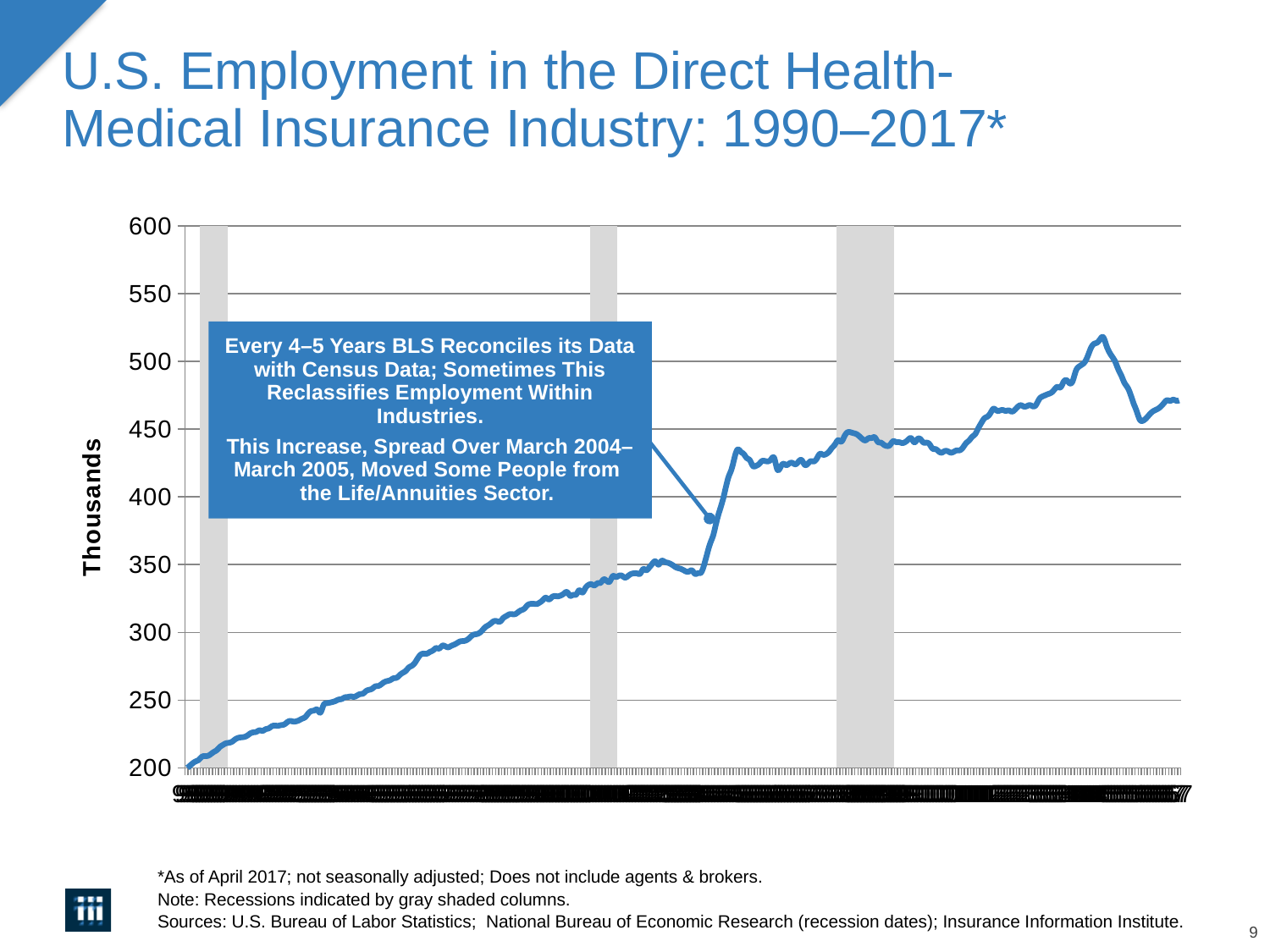
What is the highest tick value shown on the vertical axis? 600 What kind of chart is shown on the slide? line chart Is the value of the line just before the sharp jump (early 2004) greater or less than 400? less How many gray shaded recession columns are shown on the chart? 3 Is the first point of the line (1990) greater or less than 250? less What is the label on the vertical axis? Thousands Overall, do the values rise or fall from the left of the x axis to the right? rise Is the highest point of the line greater or less than 500? greater How many lines are plotted on the chart? 1